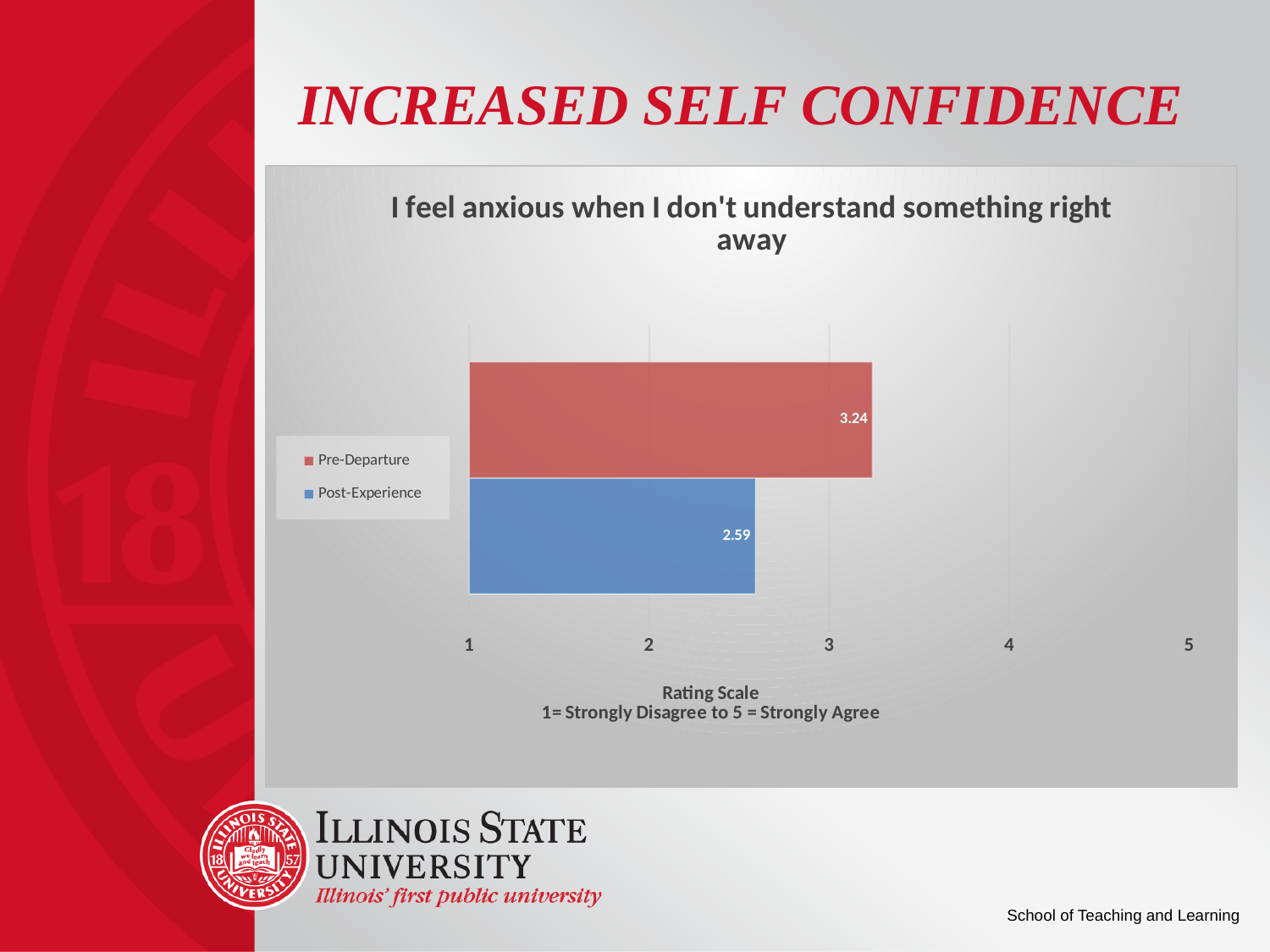
Is the Pre-Departure value greater or less than 3? greater Which series has the higher value, Pre-Departure or Post-Experience? Pre-Departure What is the label of the horizontal axis? Rating Scale 1= Strongly Disagree to 5 = Strongly Agree What is the title of the chart? I feel anxious when I don't understand something right away What is the Pre-Departure value for "I feel anxious when I don't understand something right away"? 3.24 What kind of chart is shown on the slide? Bar chart What is the difference between the Pre-Departure and Post-Experience values? 0.65 What is the highest value shown on the horizontal axis? 5 Is the Post-Experience value greater or less than 3? less How many series does the legend list? 2 Which series has the lowest value on the chart? Post-Experience What is the Post-Experience value for "I feel anxious when I don't understand something right away"? 2.59